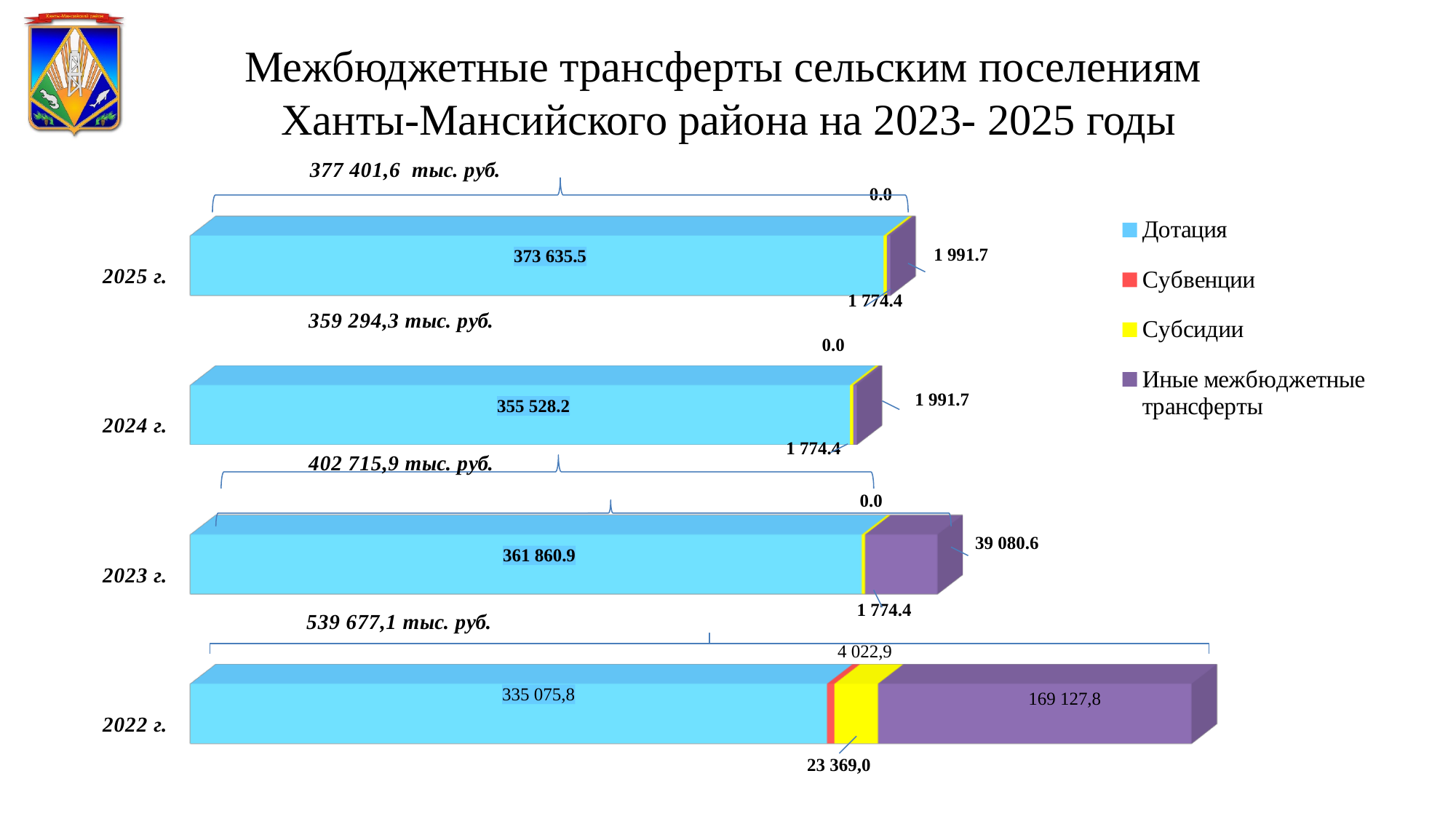
What is the value of Дотация for 2025 г.? 373 635.5 What kind of chart is shown on the slide? Stacked bar chart What is the value of Иные межбюджетные трансферты for 2023 г.? 39 080.6 What is the total of the stacked bar for 2024 г.? 359 294,3 тыс. руб. What is the total of the stacked bar for 2022 г.? 539 677,1 тыс. руб. Which year has the highest value of Дотация? 2025 г. Which year has the lowest value of Иные межбюджетные трансферты? 2024 г. and 2025 г. (1 991.7) What is the value of Субсидии for 2022 г.? 23 369,0 How many years (categories) are shown in the chart? 4 What is the value of Субвенции for 2022 г.? 4 022,9 What is the difference between the Дотация values for 2025 г. and 2024 г.? 18 107.3 How many series does the legend list? 4